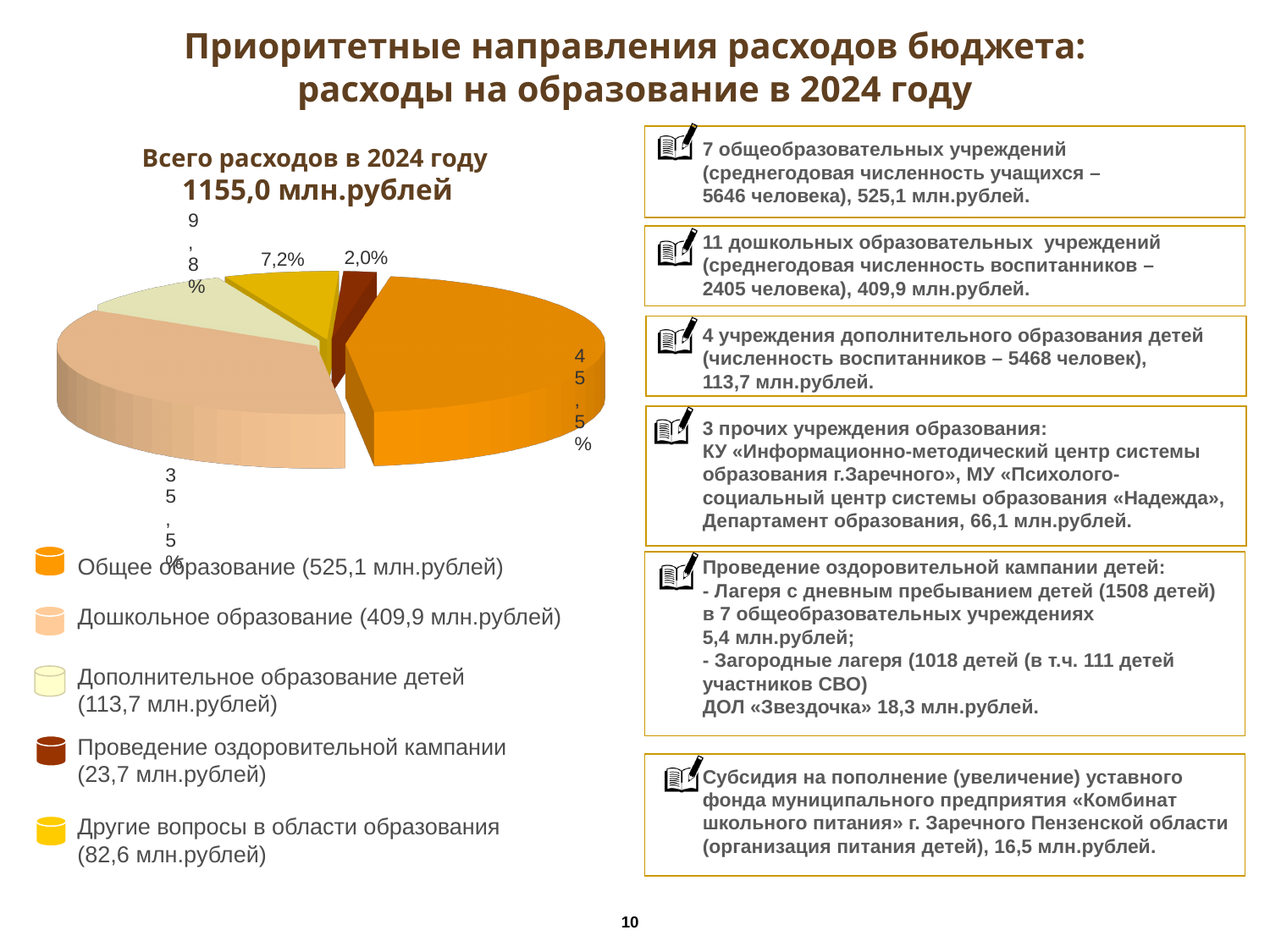
What share of the pie does Общее образование take? 45,5% What total amount of expenditure in 2024 is stated in the chart title? 1155,0 млн.рублей According to the legend, how many млн.рублей are spent on Другие вопросы в области образования? 82,6 млн.рублей What share of the pie does Проведение оздоровительной кампании take? 2,0% What is the difference in percentage points between the Общее образование slice and the Дошкольное образование slice? 10,0% How many slices does the pie chart have? 5 What share of the pie does Дошкольное образование take? 35,5% Which category has the largest slice of the pie? Общее образование Which slice is larger: Дополнительное образование детей or Другие вопросы в области образования? Дополнительное образование детей Which category has the smallest slice of the pie? Проведение оздоровительной кампании What kind of chart is shown on the slide? pie chart